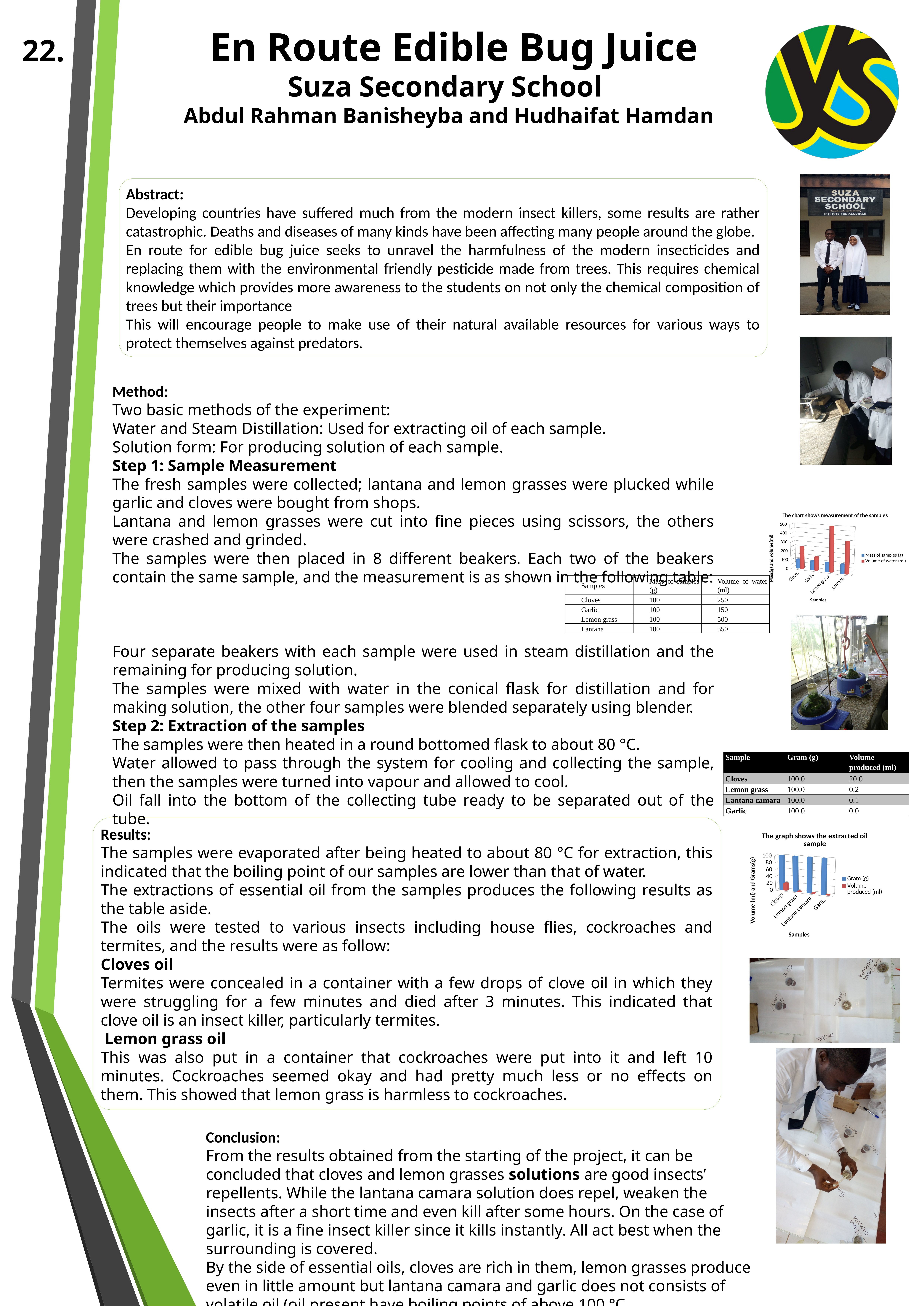
In 'The chart shows measurement of the samples', which sample has the lowest volume of water (ml)? Garlic What type of chart is 'The graph shows the extracted oil sample'? bar chart In 'The graph shows the extracted oil sample', how many series does the legend list? 2 In 'The chart shows measurement of the samples', which is larger: the volume of water for Lantana or for Cloves? Lantana In 'The graph shows the extracted oil sample', which sample has the highest volume produced (ml)? Cloves In 'The chart shows measurement of the samples', how many sample categories are shown on the x axis? 4 What type of chart is 'The chart shows measurement of the samples'? bar chart In 'The chart shows measurement of the samples', is the volume of water for Cloves greater or less than 200? greater In 'The chart shows measurement of the samples', is the volume of water for Lantana greater or less than 300? greater In 'The chart shows measurement of the samples', how many series does the legend list? 2 In 'The chart shows measurement of the samples', which sample has the highest volume of water (ml)? Lemon grass In 'The graph shows the extracted oil sample', what is the x-axis title? Samples